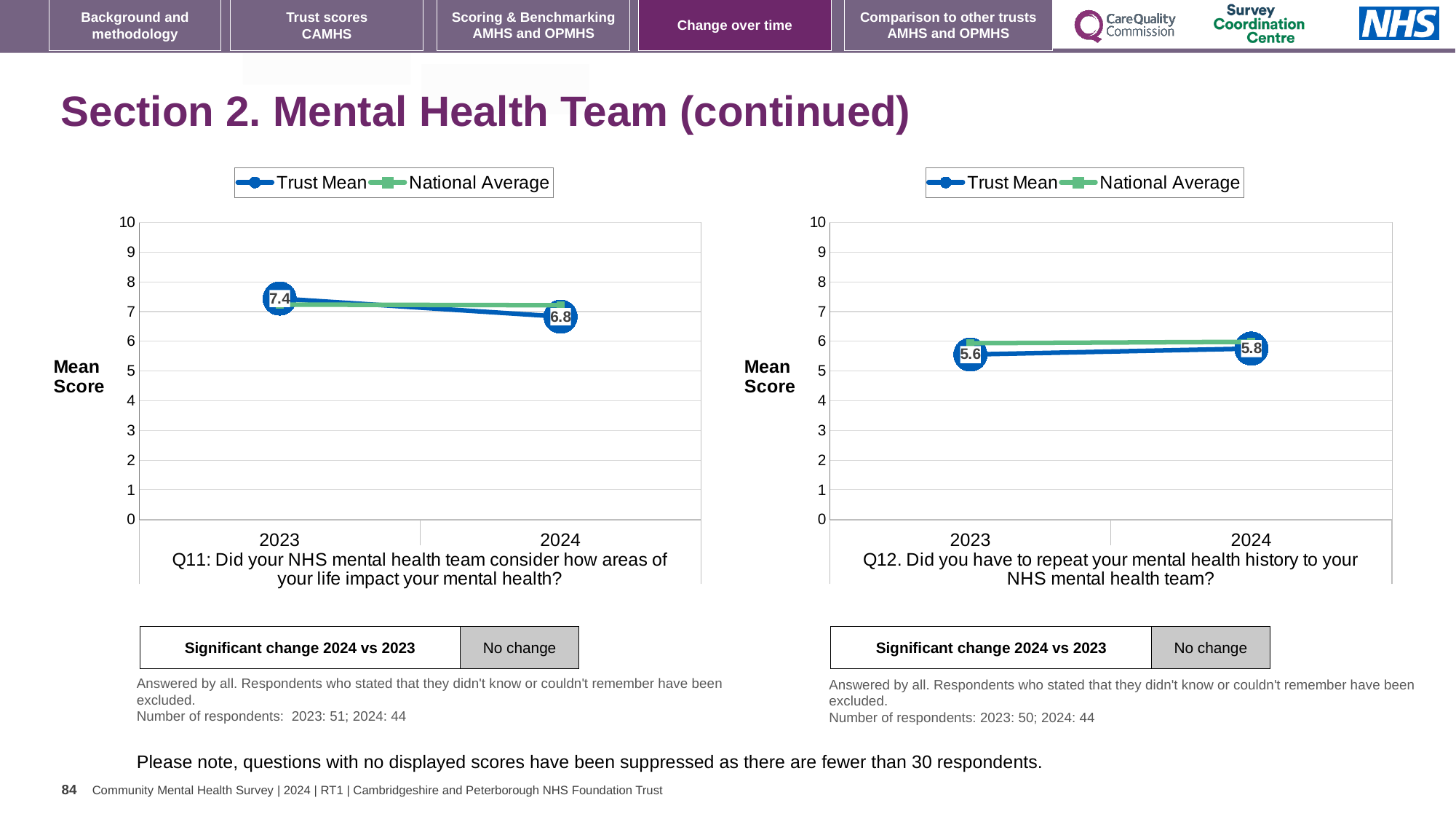
In the Q12 chart (right), what is the difference between the Trust Mean for 2024 and 2023? 0.2 In the Q11 chart (left), does the Trust Mean rise or fall from 2023 to 2024? fall In the Q12 chart (right), is the National Average value for 2023 greater or less than 5? greater In the Q12 chart (right), what is the Trust Mean score for 2024? 5.8 In the Q11 chart (left), what is the Trust Mean score for 2023? 7.4 In the Q11 chart (left), what is the Trust Mean score for 2024? 6.8 In the Q11 chart (left), which year has the higher Trust Mean, 2023 or 2024? 2023 What type of chart is used for Q11 on the left? line chart In the Q12 chart (right), does the Trust Mean rise or fall from 2023 to 2024? rise In the Q11 chart (left), by how much did the Trust Mean fall from 2023 to 2024? 0.6 In the Q12 chart (right), what is the Trust Mean score for 2023? 5.6 How many series does the legend of the Q12 chart (right) list? 2